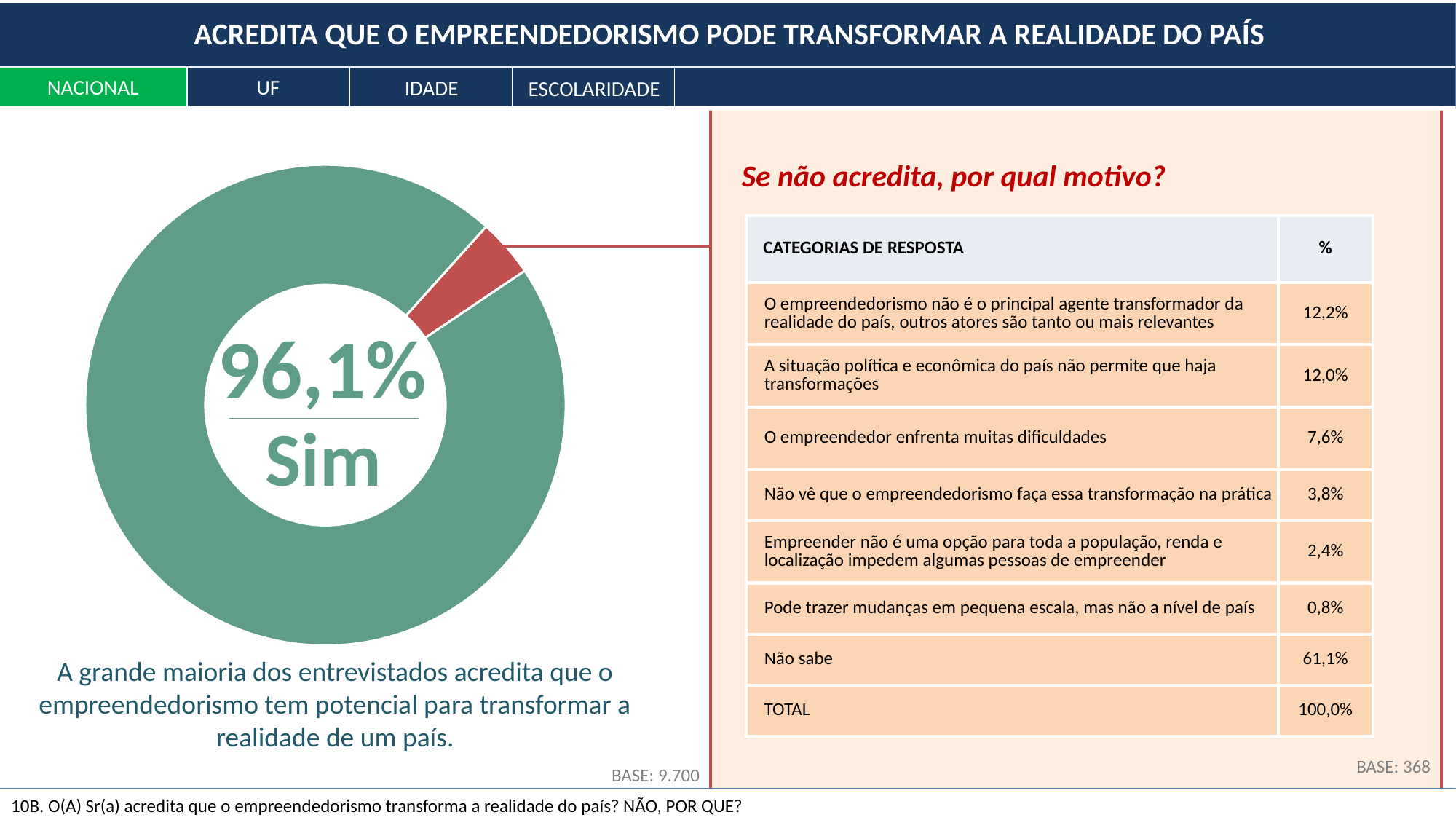
What percentage of respondents answered "Sim" in the pie chart? 96,1% Which slice of the pie chart is the largest? Sim In the pie chart, which slice is larger, the green one or the red one? the green one (Sim) What share of the pie chart does the "Sim" slice represent? 96,1% What base (number of respondents) is shown below the pie chart? 9.700 How many slices does the pie chart have? 2 What kind of chart is shown on the left of the slide? pie chart (donut) What colour is the "Sim" slice in the pie chart? green Is the value for "Sim" in the pie chart greater or less than 90%? greater